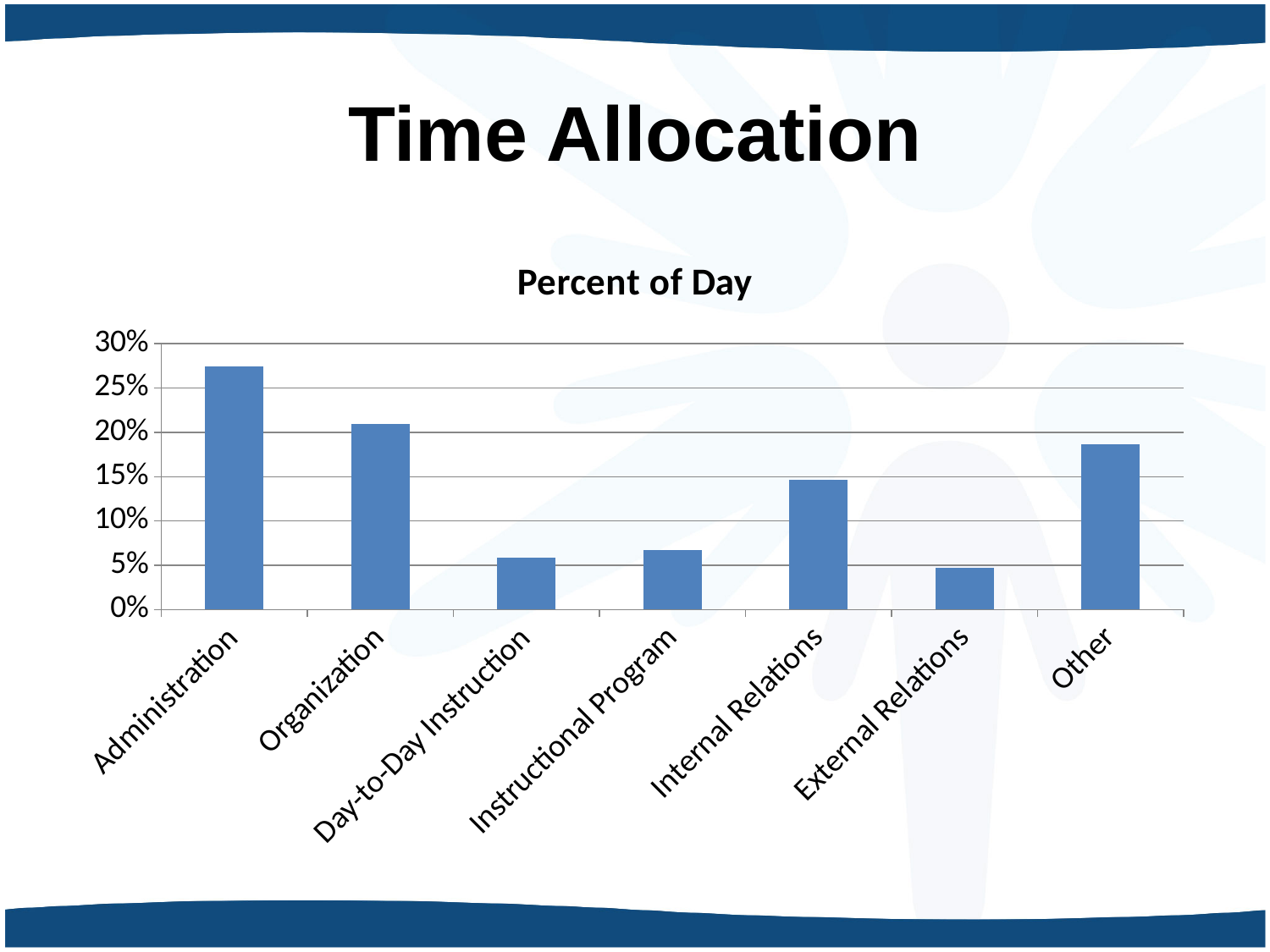
Which category has the highest percent of day? Administration Is the value for Day-to-Day Instruction greater or less than 10%? less Which is larger, the value for Organization or the value for Other? Organization Is the value for Administration greater or less than 25%? greater What kind of chart is shown on the slide? bar chart Is the value for Other greater or less than 15%? greater How many categories are shown on the x axis of the chart? 7 Which is larger, the value for Internal Relations or the value for Instructional Program? Internal Relations What is the title of the chart? Percent of Day Which category has the lowest percent of day? External Relations